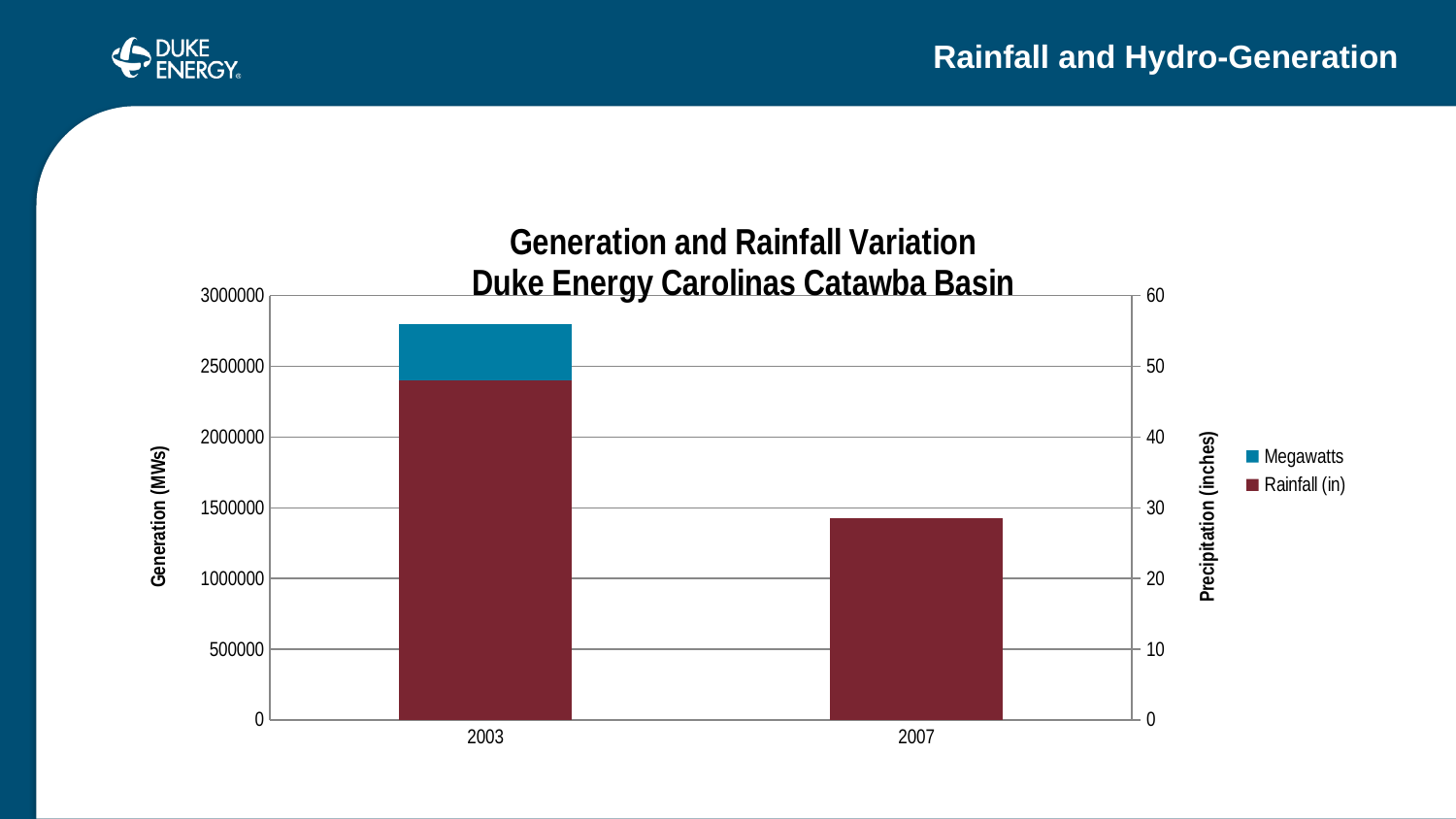
Is the Rainfall (in) value for 2003 greater or less than 40? greater Is the Rainfall (in) value for 2007 greater or less than 40? less Is the Megawatts value for 2003 greater or less than 2500000? greater Which year has the higher Rainfall (in) value, 2003 or 2007? 2003 How many years are shown on the x axis of the chart? 2 Which year has the lowest Rainfall (in) value? 2007 Does the Rainfall (in) value rise or fall from 2003 to 2007? fall What kind of chart is shown on the slide? bar chart What is the title of the chart? Generation and Rainfall Variation Duke Energy Carolinas Catawba Basin What is the label of the right-hand vertical axis of the chart? Precipitation (inches) How many series does the chart's legend list? 2